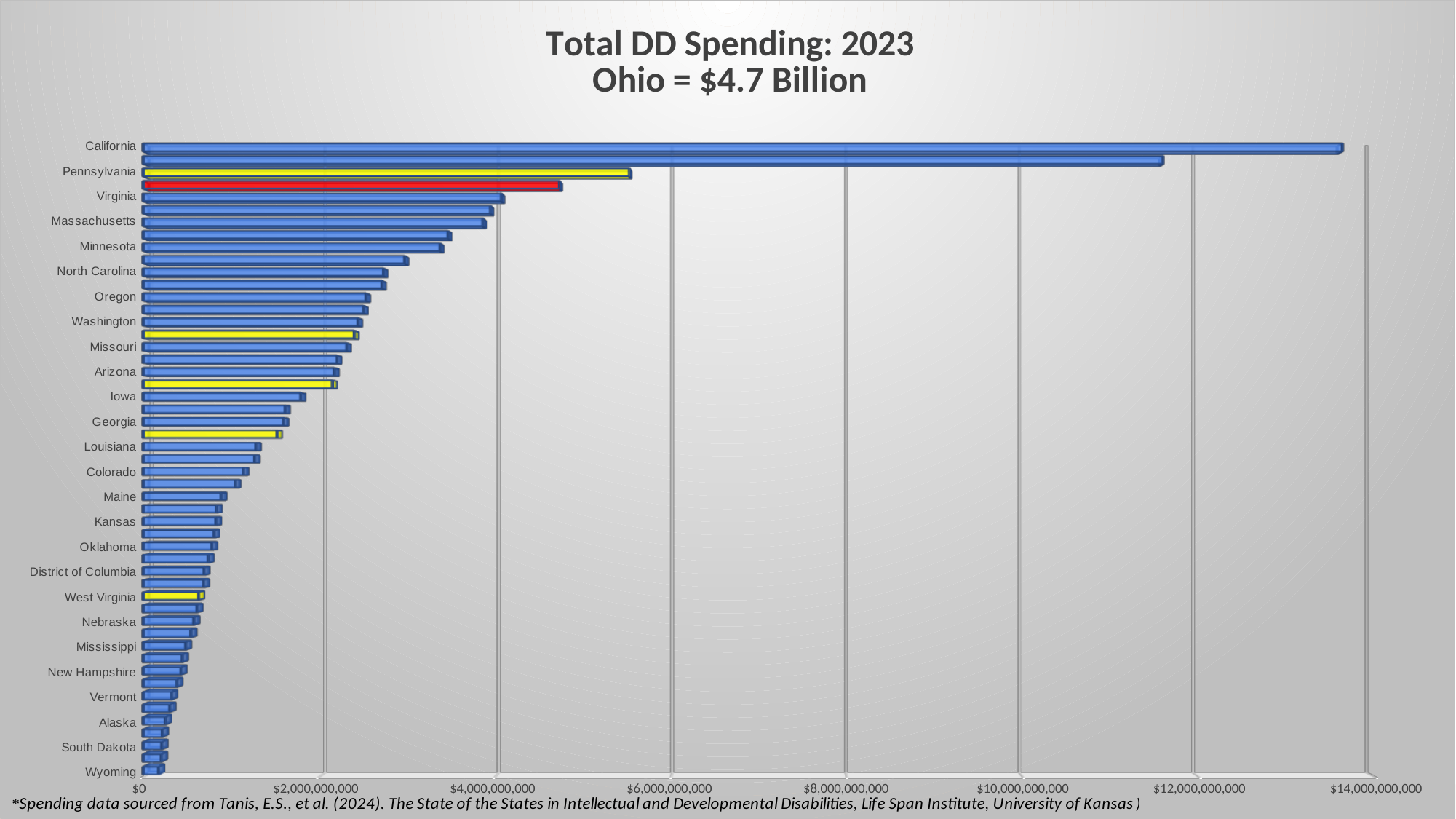
Is the value for Pennsylvania greater or less than $4,000,000,000? greater What type of chart is shown on the slide? bar chart According to the chart title, what was Ohio's total DD spending in 2023? $4.7 Billion Which labeled state has the lowest total DD spending in the chart? Wyoming Which has higher total DD spending, Virginia or Georgia? Virginia Do the bar values increase or decrease going from the top of the chart to the bottom? decrease What is the title of the chart? Total DD Spending: 2023 Ohio = $4.7 Billion Is the value for Minnesota greater or less than $4,000,000,000? less Is the value for Virginia greater or less than $6,000,000,000? less Which state has the highest total DD spending in the chart? California